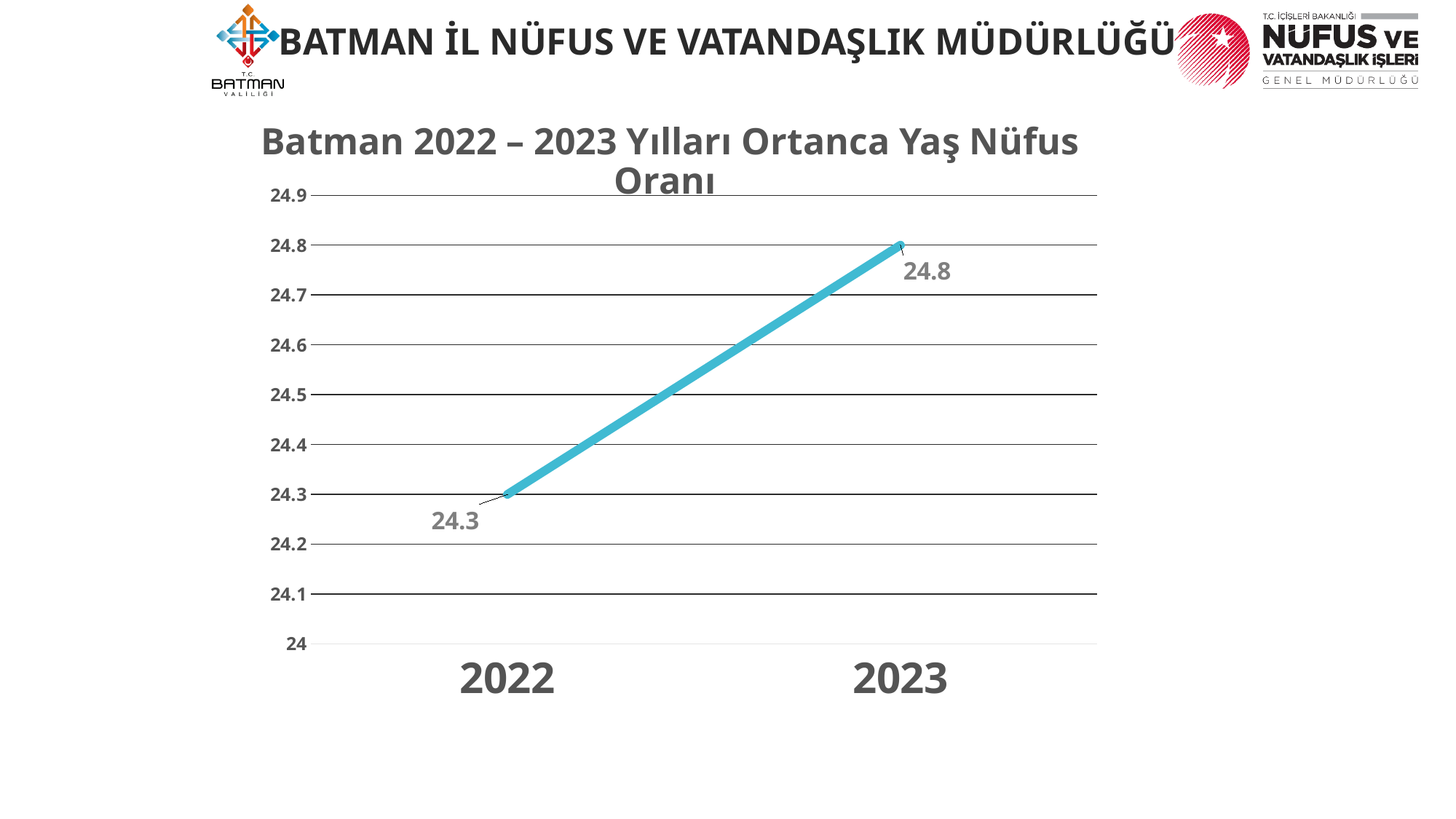
How many years are plotted on the x axis? 2 What is the median age value for 2022? 24.3 Does the value rise or fall from 2022 to 2023? rise What kind of chart is shown on the slide? line chart Is the value for 2022 larger or smaller than the value for 2023? smaller What is the median age value for 2023? 24.8 Which year has the lower median age value? 2022 What is the difference between the 2023 and 2022 values? 0.5 Which year has the higher median age value? 2023 What is the highest value shown on the y axis? 24.9 What is the title of the chart? Batman 2022 – 2023 Yılları Ortanca Yaş Nüfus Oranı Is the value for 2023 greater or less than 24.5? greater